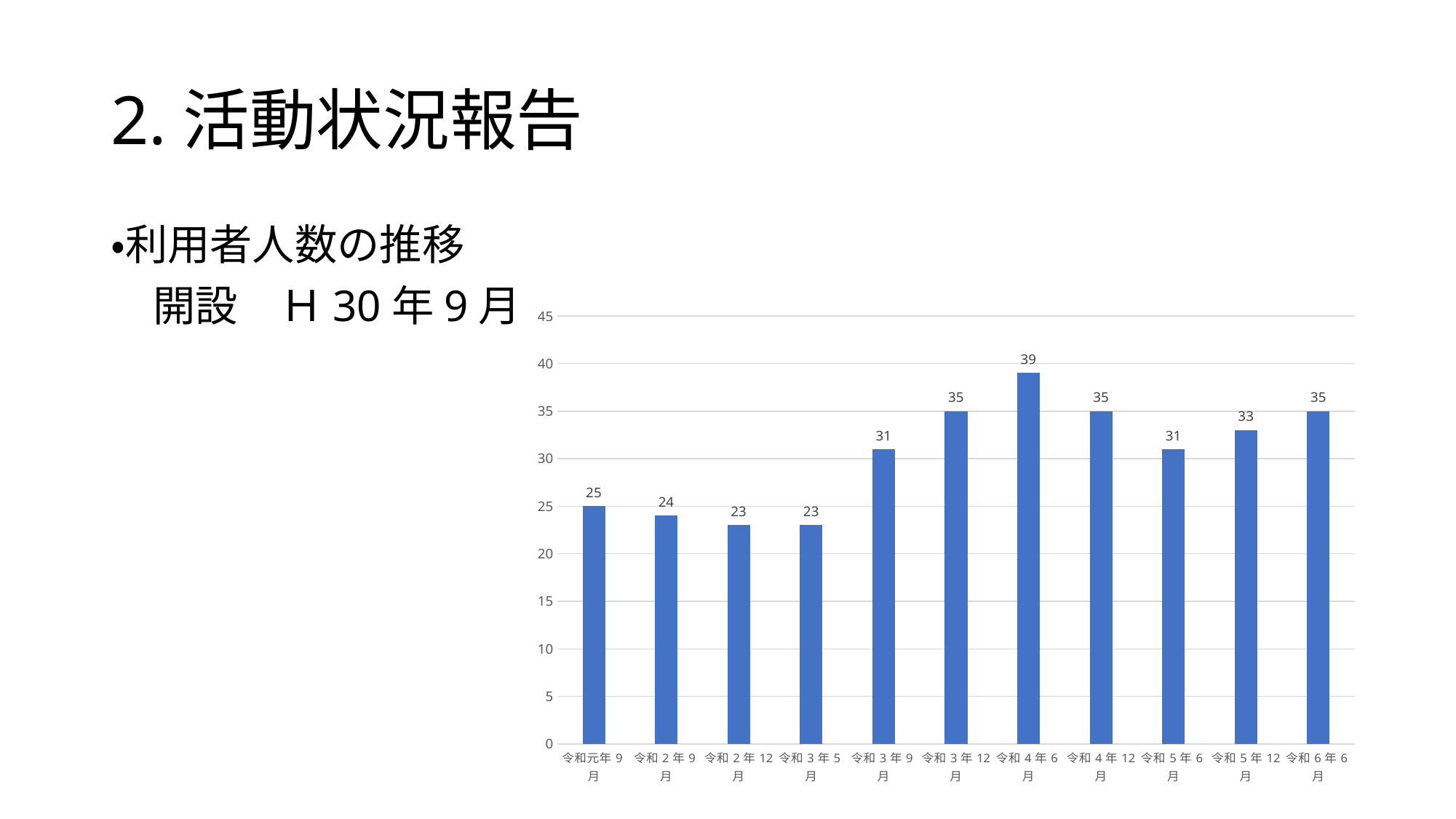
What is the value for 令和5年12月? 33 What is the value for 令和元年9月? 25 Do the values rise or fall from 令和3年5月 to 令和4年6月? rise What is the lowest value shown in the chart? 23 What is the difference between the values for 令和3年12月 and 令和3年9月? 4 What kind of chart is shown on the slide? bar chart What is the difference between the values for 令和4年6月 and 令和元年9月? 14 Is the value for 令和4年12月 greater or less than 30? greater What is the value for 令和4年6月? 39 Which category has the highest value? 令和4年6月 Which is larger, the value for 令和2年9月 or the value for 令和5年6月? 令和5年6月 How many bars are shown in the chart? 11